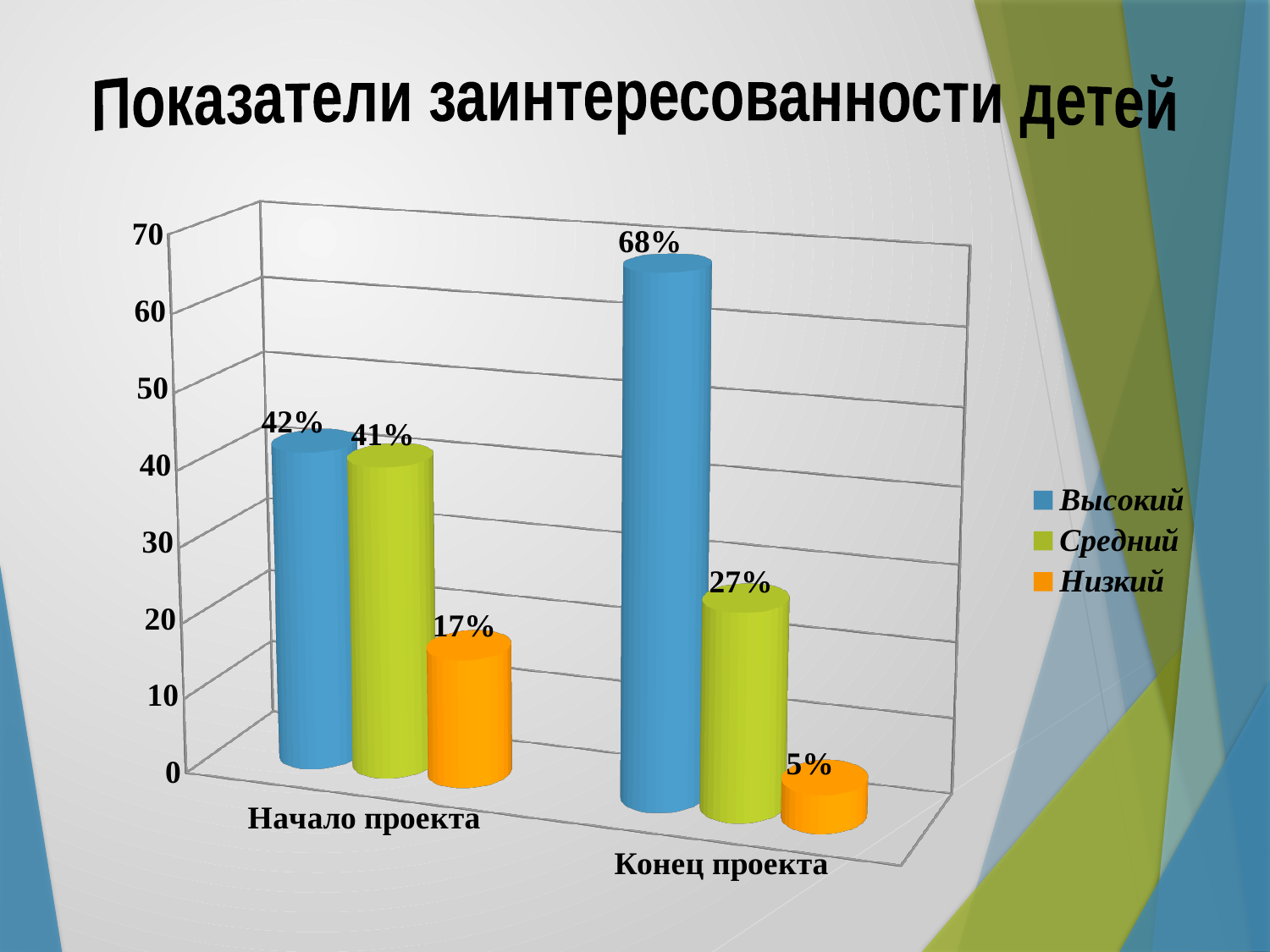
What is the value for Средний at Конец проекта? 27% How many categories are shown on the x axis? 2 How many series does the legend list? 3 What is the difference between the Высокий values at Конец проекта and Начало проекта? 26% Which series has the lowest value at Начало проекта? Низкий Does the Низкий value rise or fall from Начало проекта to Конец проекта? Fall What is the value for Низкий at Конец проекта? 5% What kind of chart is shown on the slide? Bar chart What is the title of the slide? Показатели заинтересованности детей Which is larger: Средний at Начало проекта or Средний at Конец проекта? Средний at Начало проекта Which series has the highest value at Конец проекта? Высокий What is the value for Высокий at Начало проекта? 42%